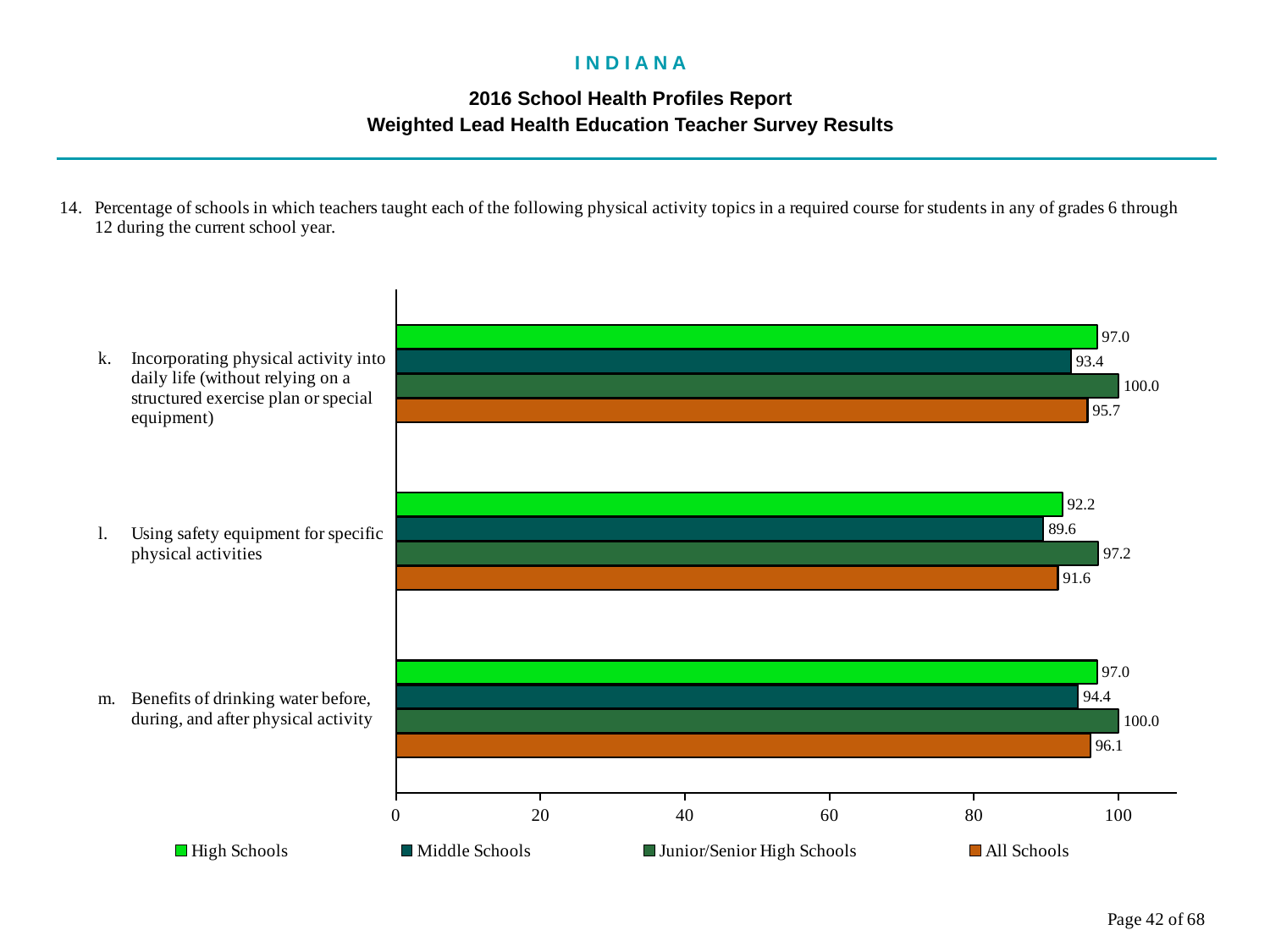
What is the difference between the High Schools and Middle Schools values for topic l, using safety equipment for specific physical activities? 2.6 How many series does the legend list? 4 Is the Middle Schools value for topic l, using safety equipment for specific physical activities, greater or less than 80? greater Which is larger for topic k: the High Schools value or the All Schools value? High Schools What kind of chart is shown on the slide? Bar chart What is the value for Junior/Senior High Schools for topic k, incorporating physical activity into daily life? 100.0 Which school type has the lowest value for topic l, using safety equipment for specific physical activities? Middle Schools How many physical activity topics are shown on the chart? 3 What is the value for All Schools for topic m, benefits of drinking water before, during, and after physical activity? 96.1 Which school type has the highest value for topic m, benefits of drinking water before, during, and after physical activity? Junior/Senior High Schools Which legend entry is shown in orange? All Schools What is the value for Middle Schools for topic l, using safety equipment for specific physical activities? 89.6